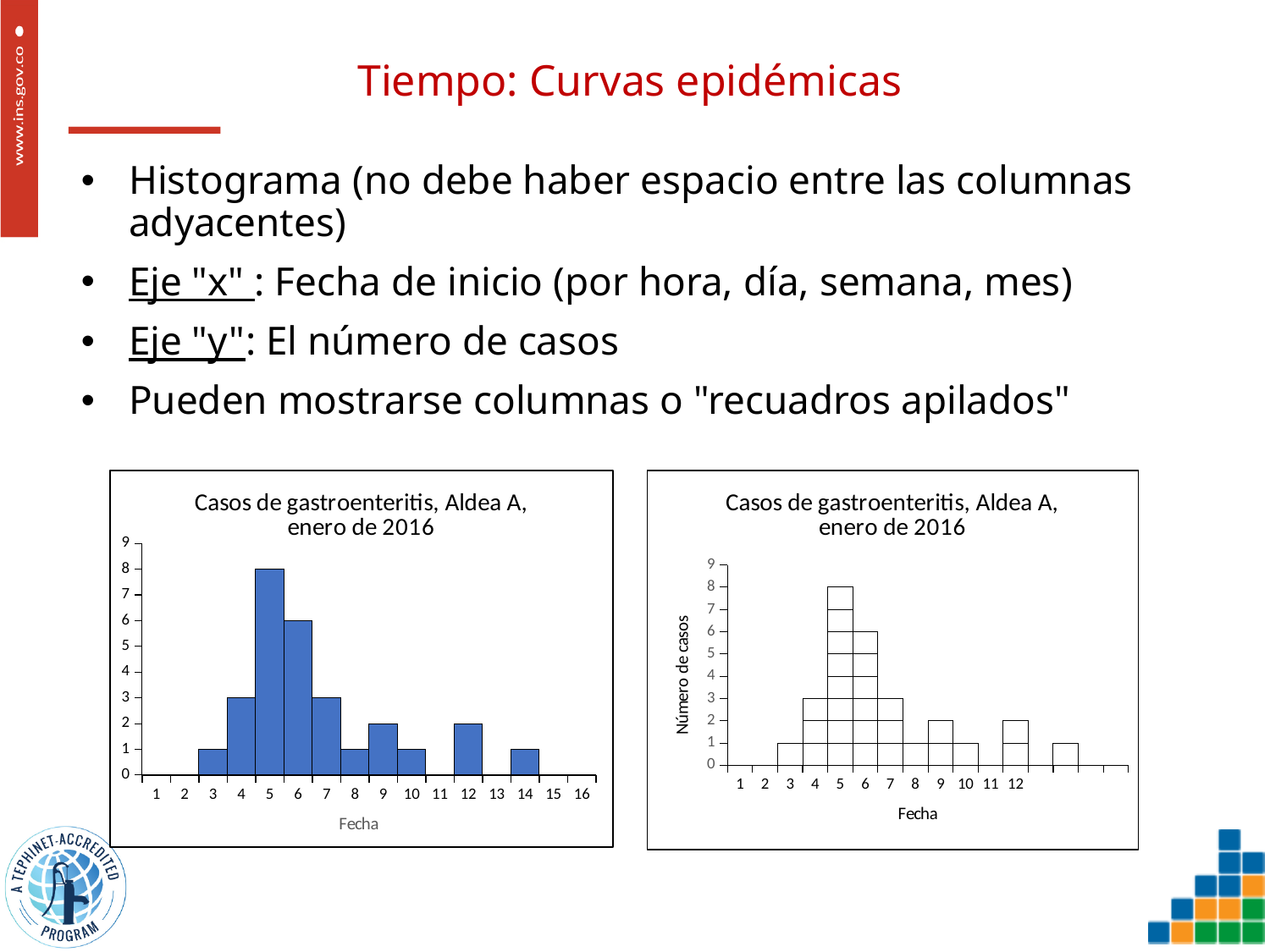
In the left chart, how many cases are shown for date 5? 8 In the left chart, how many cases are shown for date 12? 2 In the left chart, which date has the highest number of cases? 5 What kind of chart is the left chart? Bar chart How many dates are labelled on the x axis of the left chart? 16 In the left chart, what is the difference between the number of cases on date 5 and on date 6? 2 What is the x-axis title of the left chart? Fecha In the right chart, how many cases are shown for date 5? 8 In the left chart, which has more cases, date 4 or date 9? Date 4 What is the y-axis title of the right chart? Número de casos In the left chart, is the value for date 5 greater or less than 5? greater In the left chart, how many cases are shown for date 6? 6